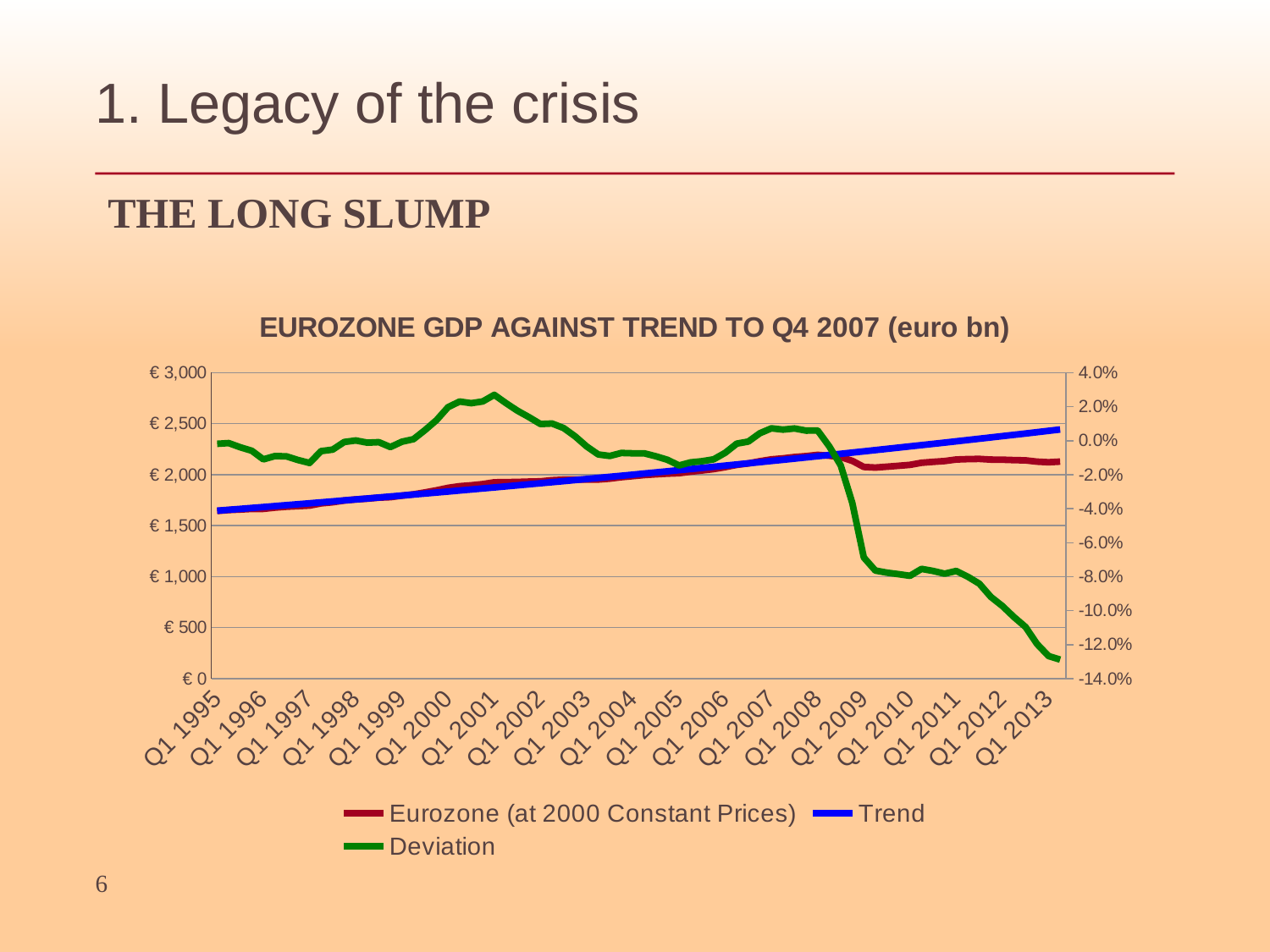
What is the title of the chart? EUROZONE GDP AGAINST TREND TO Q4 2007 (euro bn) At Q1 2013, which is higher: the Trend series or the Eurozone (at 2000 Constant Prices) series? Trend How many series does the legend list? 3 Which series is drawn in green? Deviation What kind of chart is shown on the slide? line chart Is the value of the Eurozone (at 2000 Constant Prices) series at Q1 1995 greater or less than € 1,500? greater Is the value of the Deviation series at Q1 2009 greater or less than -6.0%? less Does the Trend series rise or fall from Q1 1995 to Q1 2013? rise Is the value of the Deviation series at Q1 2013 greater or less than -12.0%? less How many quarter labels are shown on the x axis? 19 Does the Deviation series rise or fall from Q1 2008 to Q1 2013? fall